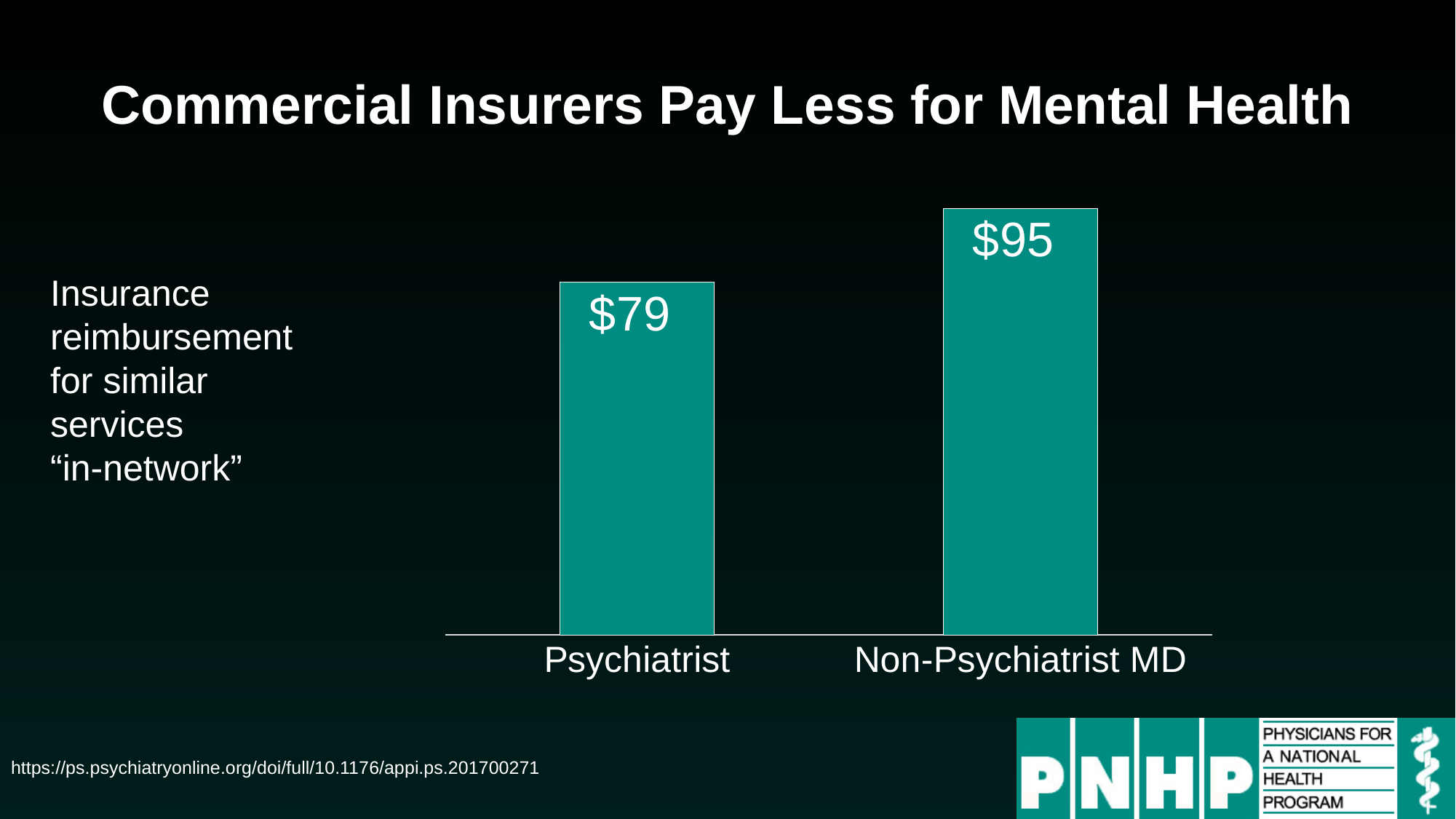
What is the difference between the Non-Psychiatrist MD and Psychiatrist reimbursement values? $16 How many categories are shown in the chart? 2 What is the title of the slide containing the chart? Commercial Insurers Pay Less for Mental Health What colour are the bars in the chart? teal Do the values rise or fall from Psychiatrist to Non-Psychiatrist MD? rise What kind of chart is shown on the slide? bar chart Which category has the lower reimbursement value? Psychiatrist What is the insurance reimbursement value shown for Non-Psychiatrist MD? $95 Is the value for Psychiatrist larger or smaller than the value for Non-Psychiatrist MD? smaller Which category has the higher reimbursement value? Non-Psychiatrist MD What is the insurance reimbursement value shown for Psychiatrist? $79